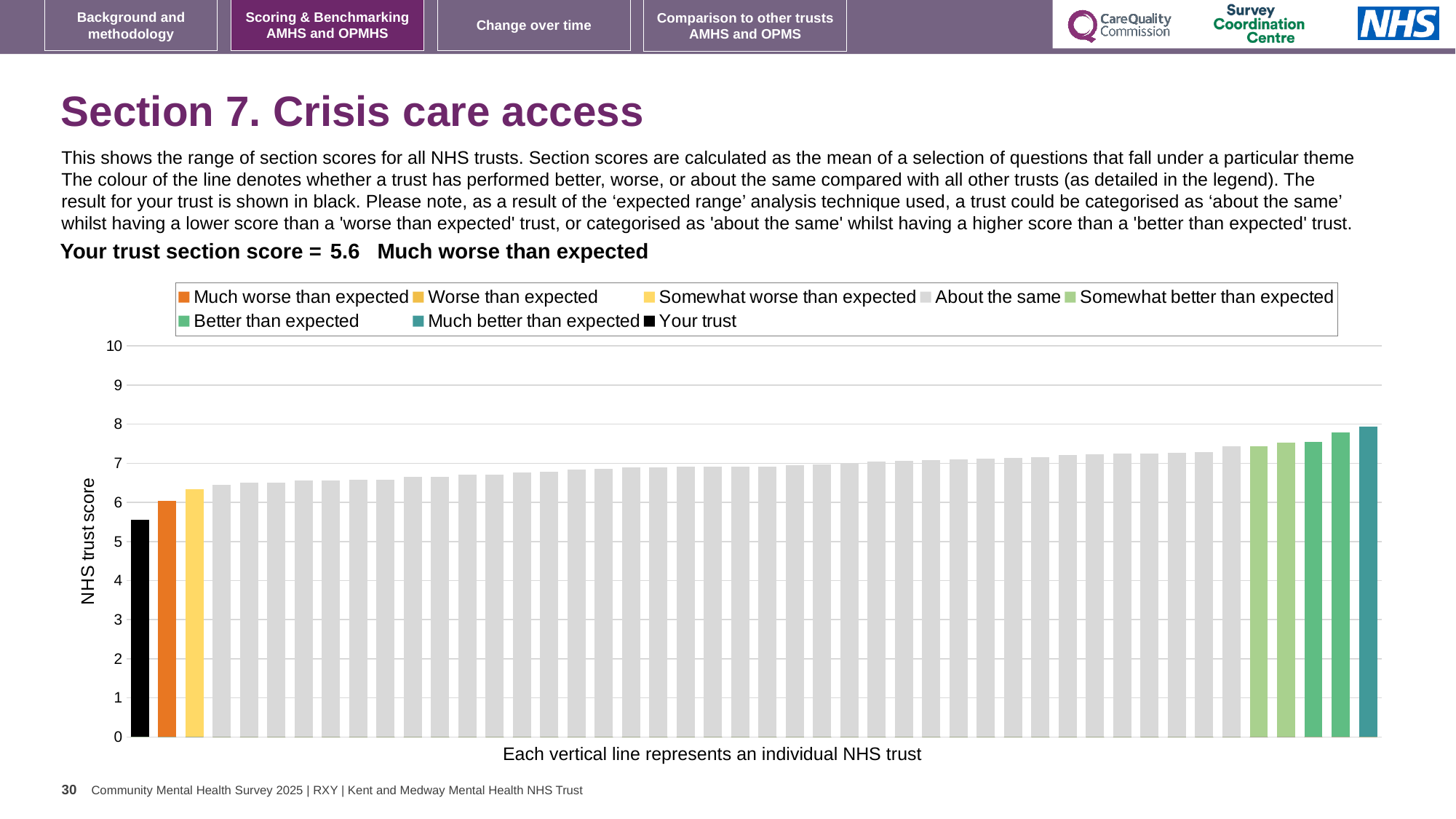
How many entries does the chart legend list? 8 What is the section score for your trust? 5.6 Do the bar values rise or fall from left to right across the chart? rise Is the value of the black 'Your trust' bar greater or less than 6? less Which category is your trust placed in for this section? Much worse than expected What kind of chart is shown on the slide? bar chart Is the value of the tallest bar (the teal 'Much better than expected' bar) greater or less than 7? greater What is the label on the vertical axis? NHS trust score What colour is used for the 'Your trust' bar? black Which legend category does the tallest bar belong to? Much better than expected Which bar is the lowest in the chart? Your trust (the black bar) Is the value of the tallest bar greater or less than 8? less